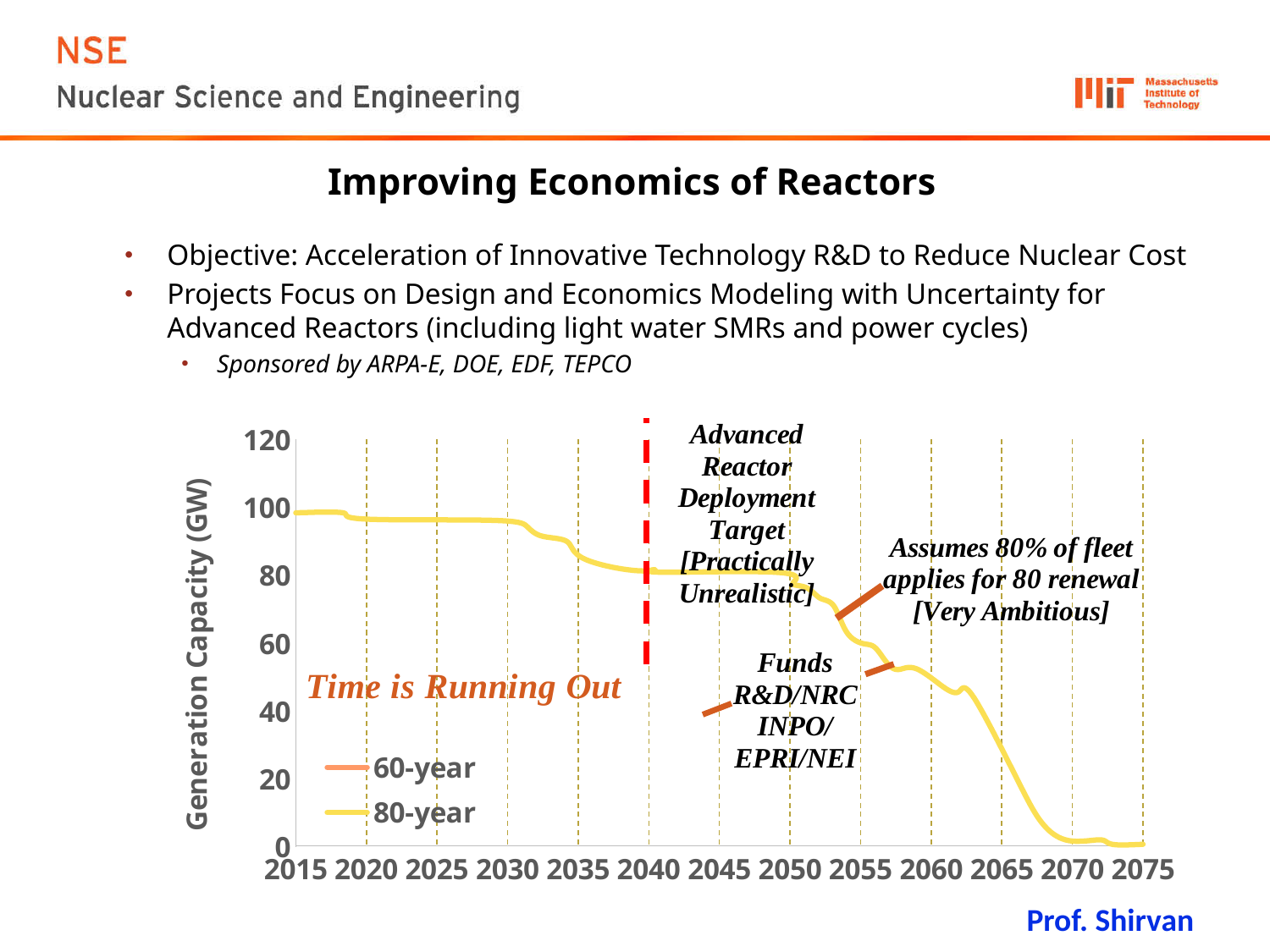
Is the 80-year value in 2070 greater or less than 20? less Is the 80-year value in 2015 greater or less than 80? greater What are the two series named in the chart legend? 60-year and 80-year What is the label of the vertical axis of the chart? Generation Capacity (GW) What kind of chart is shown on the slide? line chart Is the 80-year value in 2040 greater or less than 100? less How many series does the chart legend list? 2 How many year labels are shown along the x axis of the chart? 13 Does the 80-year line rise or fall as the years increase from 2015 to 2075? fall